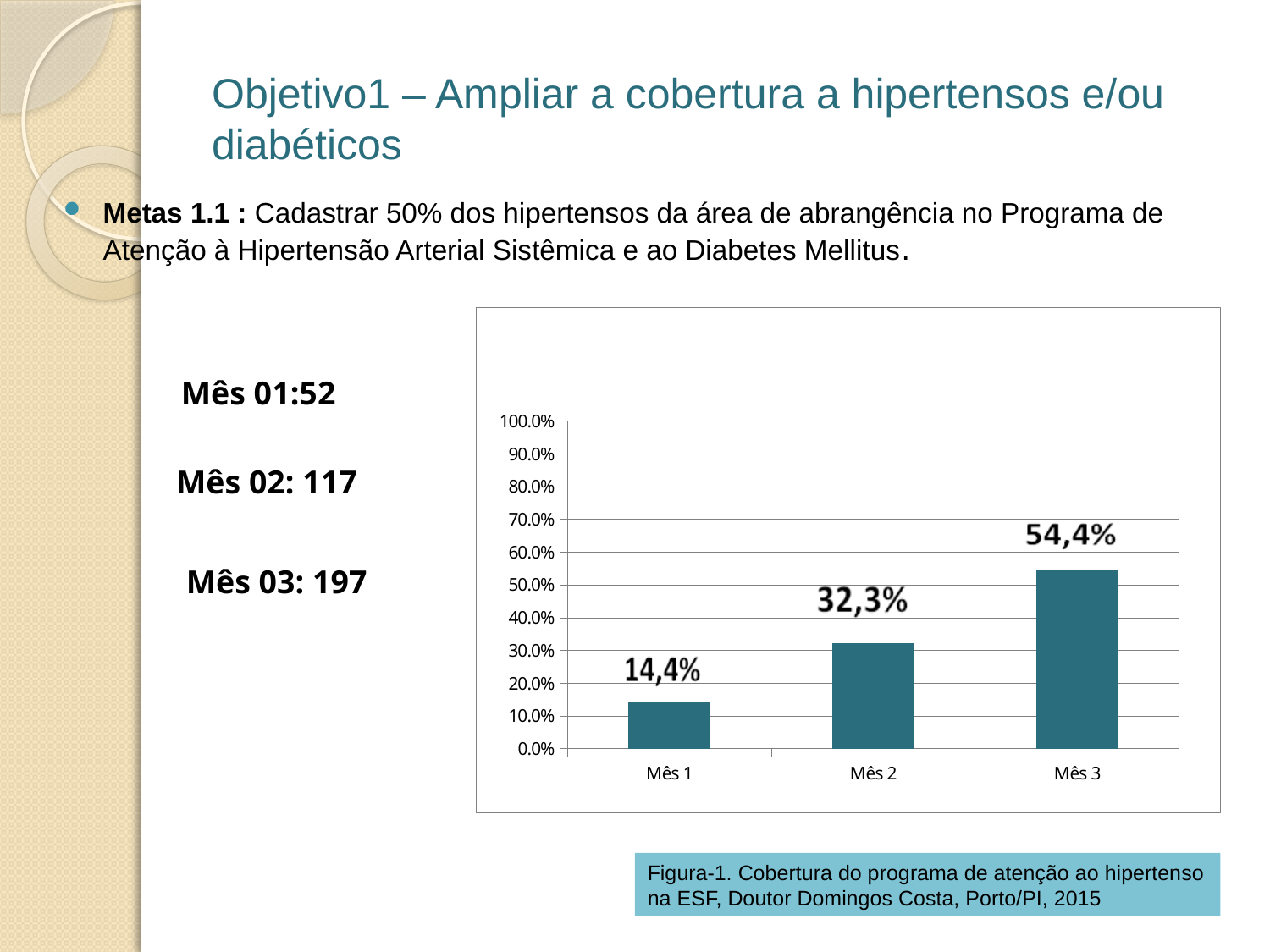
Which month has the highest value in the chart? Mês 3 What is the difference between the values for Mês 3 and Mês 1? 40,0% What kind of chart is shown on the slide? Bar chart How many bars are plotted in the chart? 3 Which is larger, the value for Mês 2 or the value for Mês 3? Mês 3 Which month has the lowest value in the chart? Mês 1 What is the difference between the values for Mês 2 and Mês 1? 17,9% What is the value shown for Mês 3? 54,4% Do the values rise or fall from Mês 1 to Mês 3? Rise Is the value for Mês 3 greater or less than 50.0%? greater What is the value shown for Mês 2? 32,3% What is the value shown for Mês 1? 14,4%